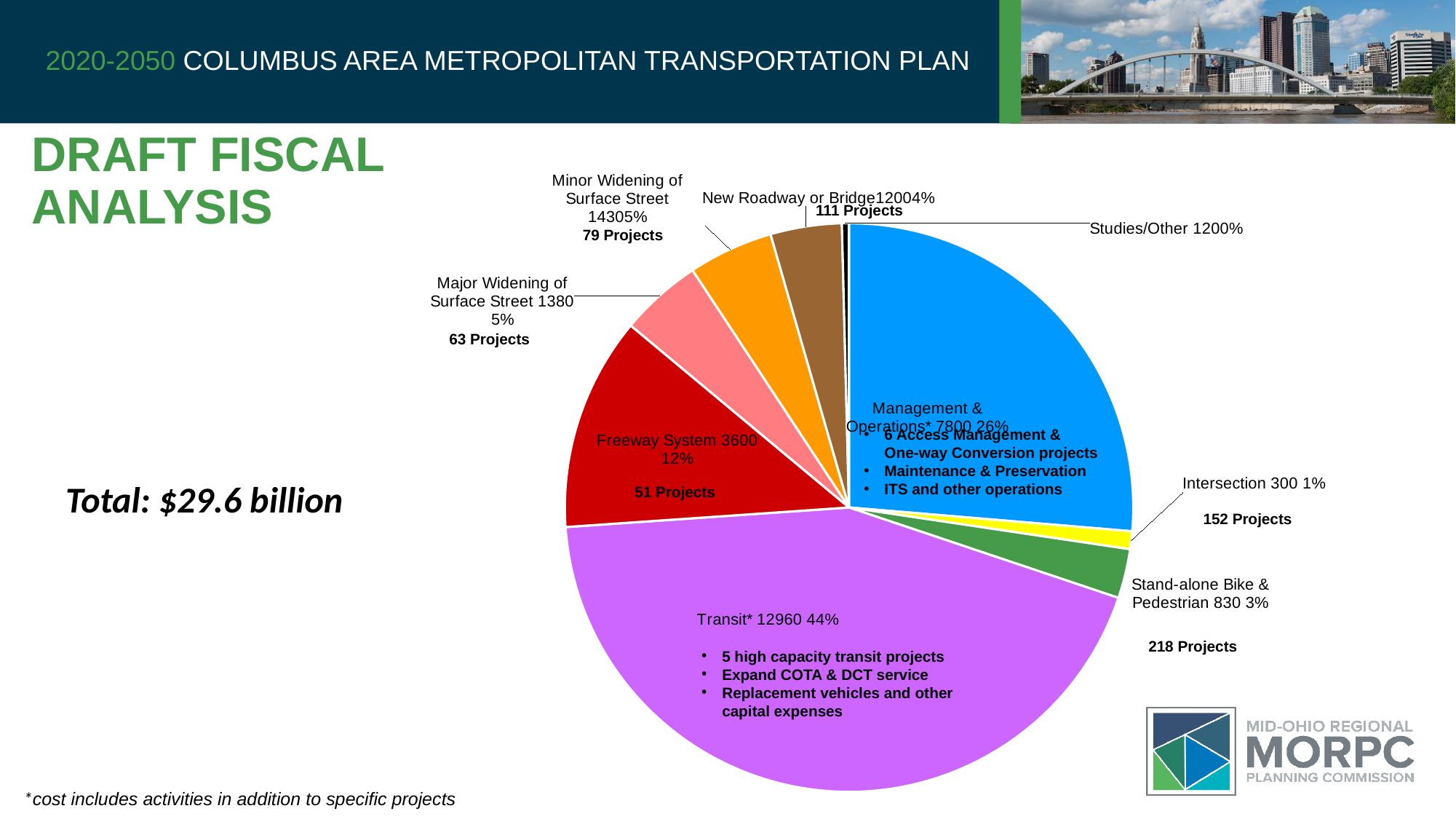
Which category has the smallest slice of the pie? Studies/Other How many projects are listed for Stand-alone Bike & Pedestrian? 218 Projects What is the difference in percentage share between Transit* and Management & Operations*? 18% What percentage share of the pie does Transit* have? 44% How many projects are listed for Intersection? 152 Projects Which category has the largest slice of the pie? Transit* What percentage share of the pie does Management & Operations* have? 26% What kind of chart is shown on the slide? pie chart What value is shown for Freeway System? 3600 How many slices does the pie chart have? 9 Which slice is larger, Freeway System or Management & Operations*? Management & Operations* What percentage is shown for Stand-alone Bike & Pedestrian? 3%